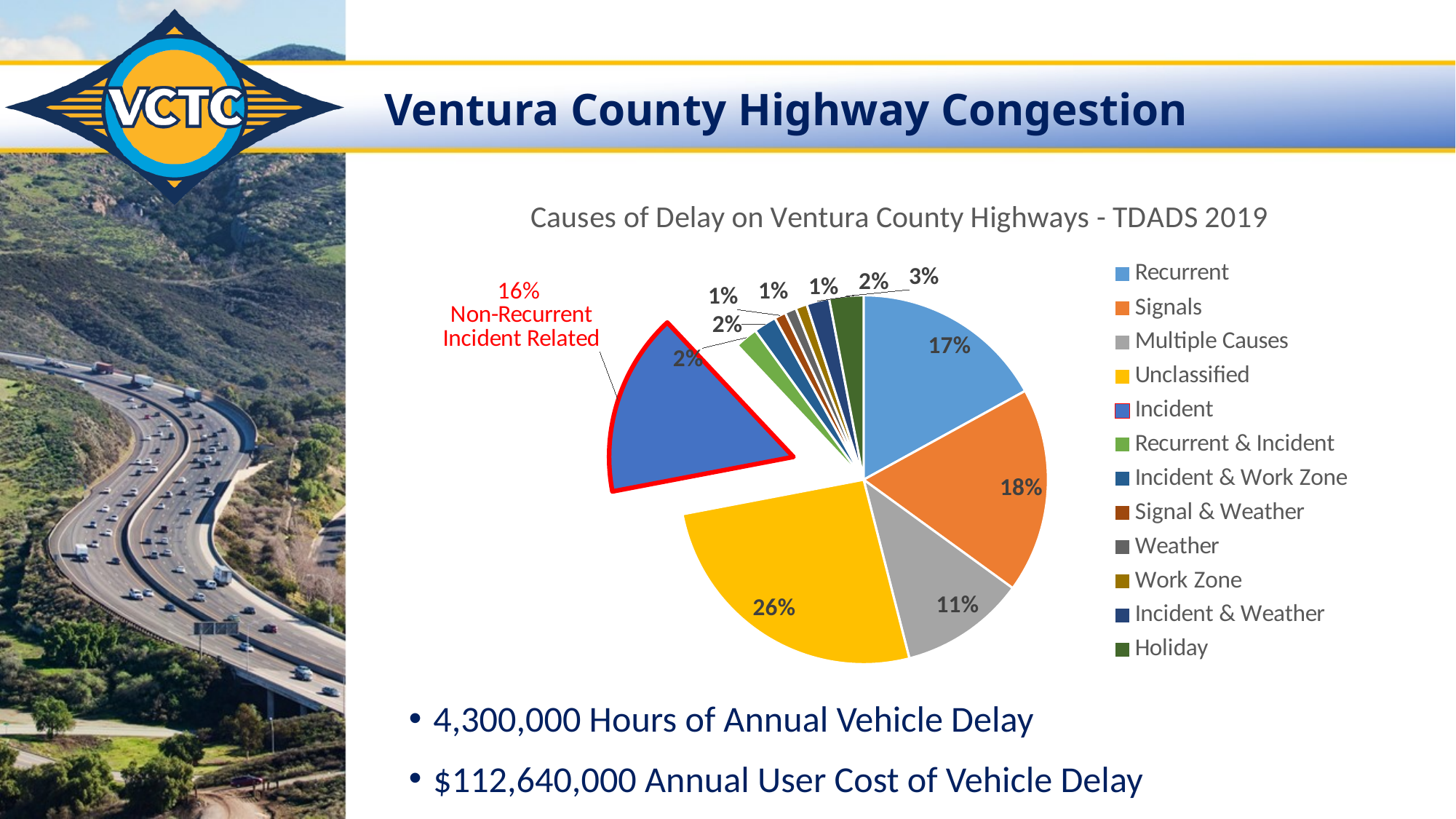
What share of the pie is Multiple Causes? 11% What is the title of the chart? Causes of Delay on Ventura County Highways - TDADS 2019 What is the difference between the Unclassified share and the Multiple Causes share? 15% How many categories does the legend of the pie chart list? 12 What share of the pie is Signals? 18% Which category has the largest share of the pie? Unclassified What share of the pie is the exploded Incident slice? 16% What kind of chart is shown on the slide? pie chart Which is larger, the share for Signals or the share for Recurrent? Signals